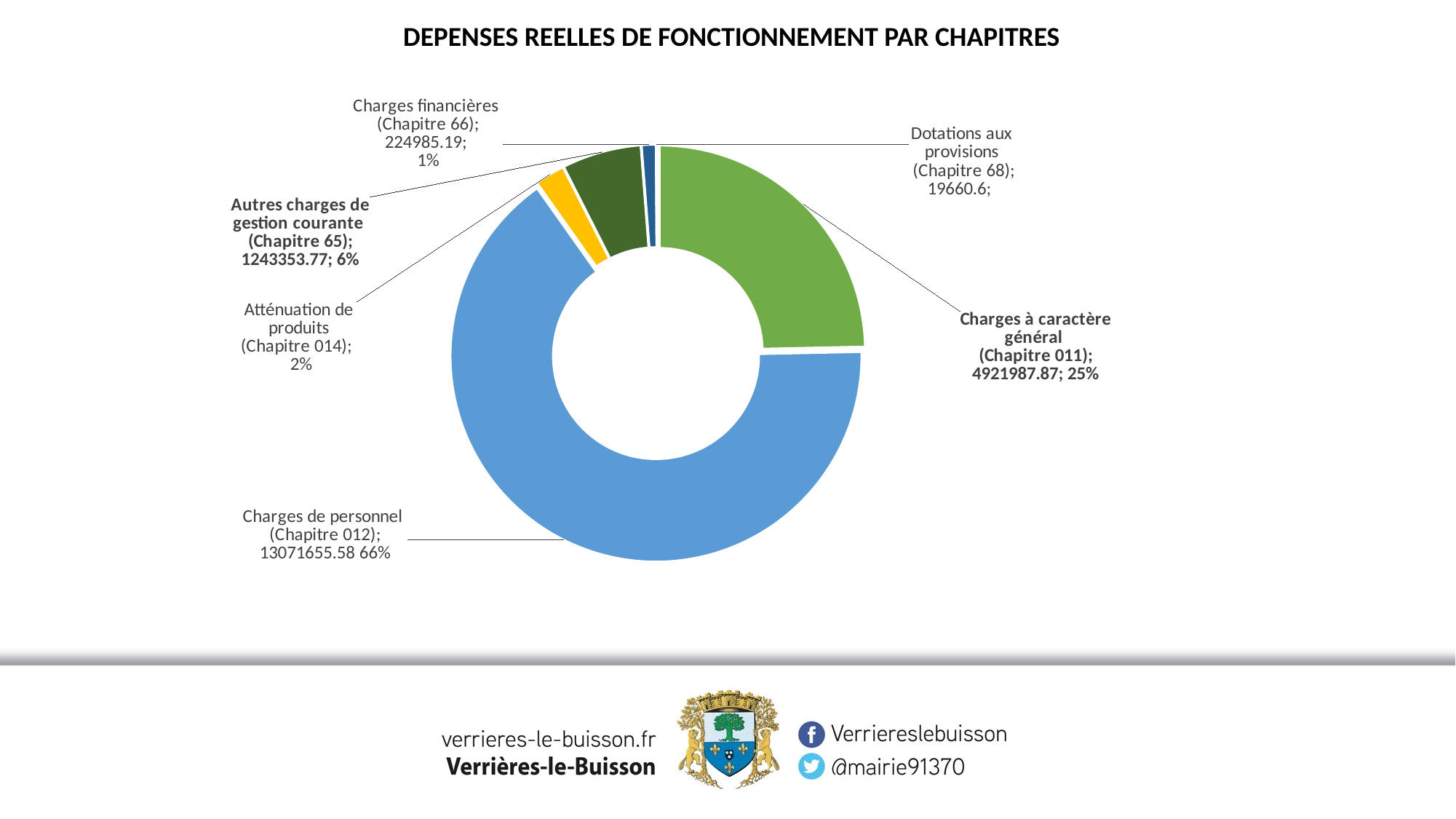
How many slices does the chart have? 6 What is the title of the chart? DEPENSES REELLES DE FONCTIONNEMENT PAR CHAPITRES What is the difference in percentage points between the share of Charges de personnel (Chapitre 012) and Charges à caractère général (Chapitre 011)? 41% What is the value shown for Charges de personnel (Chapitre 012)? 13071655.58 What is the value shown for Dotations aux provisions (Chapitre 68)? 19660.6 Which chapter has the largest share of the chart? Charges de personnel (Chapitre 012) What percentage share is shown for Atténuation de produits (Chapitre 014)? 2% What percentage share is shown for Charges à caractère général (Chapitre 011)? 25% Which chapter has the smallest slice of the chart? Dotations aux provisions (Chapitre 68) What is the value shown for Autres charges de gestion courante (Chapitre 65)? 1243353.77 What is the value shown for Charges financières (Chapitre 66)? 224985.19 What kind of chart is shown on the slide? Pie chart (doughnut)